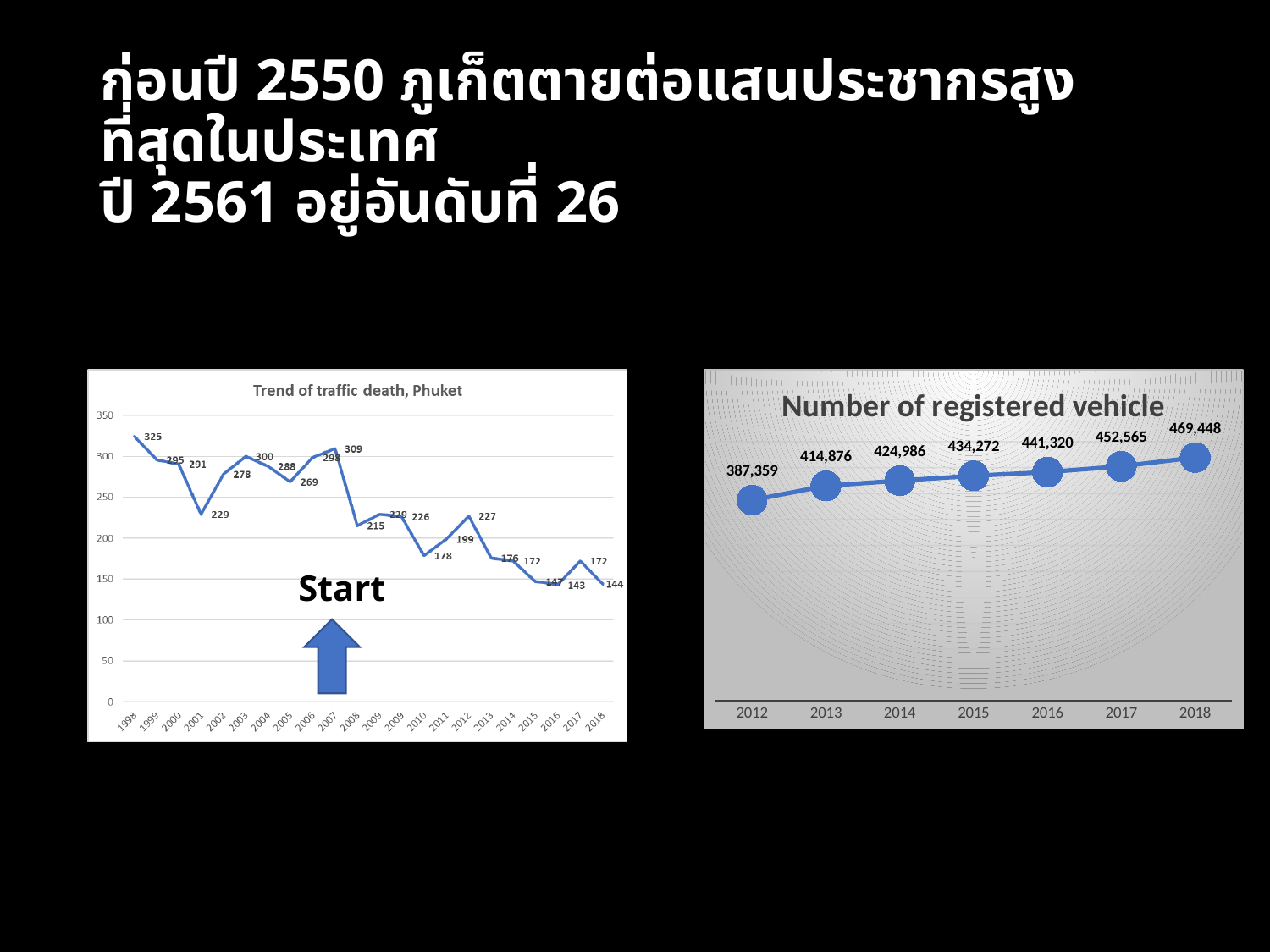
In the 'Trend of traffic death, Phuket' chart, what is the highest value shown? 325 In the 'Number of registered vehicle' chart, which year has the lowest value? 2012 In the 'Number of registered vehicle' chart, what is the value for 2015? 434,272 In the 'Number of registered vehicle' chart, what is the value for 2012? 387,359 In the 'Number of registered vehicle' chart, how many years are plotted? 7 In the 'Number of registered vehicle' chart, what is the difference between the 2018 and 2017 values? 16,883 What type of chart is the 'Trend of traffic death, Phuket' chart? line chart In the 'Number of registered vehicle' chart, do the values rise or fall from 2012 to 2018? rise In the 'Trend of traffic death, Phuket' chart, what is the value for 1998? 325 In the 'Trend of traffic death, Phuket' chart, what is the value for 2018? 144 In the 'Number of registered vehicle' chart, what is the value for 2018? 469,448 In the 'Number of registered vehicle' chart, which year has the highest value? 2018